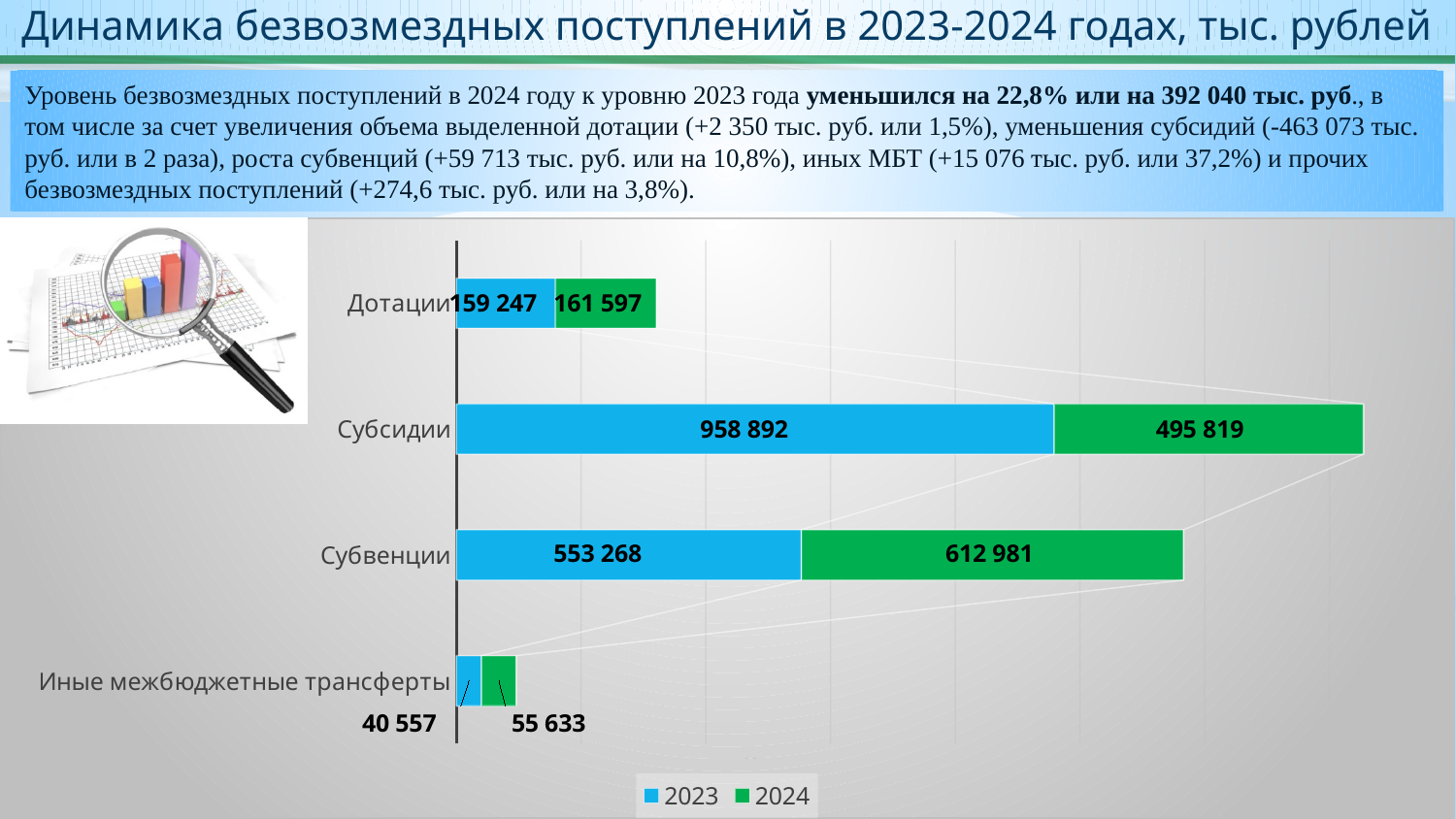
What is the value for Субсидии in 2023? 958 892 What is the value for Дотации in 2024? 161 597 Which category has the highest value in 2023? Субсидии What is the total of the stacked bar for Дотации? 320 844 What is the value for Субвенции in 2024? 612 981 Which category has the lowest value in 2024? Иные межбюджетные трансферты What is the value for Иные межбюджетные трансферты in 2023? 40 557 Which is larger for Субвенции: the 2023 value or the 2024 value? 2024 What is the difference between the 2023 and 2024 values for Субсидии? 463 073 How many categories are shown on the chart? 4 How many series does the legend list? 2 What kind of chart is shown on the slide? Stacked bar chart